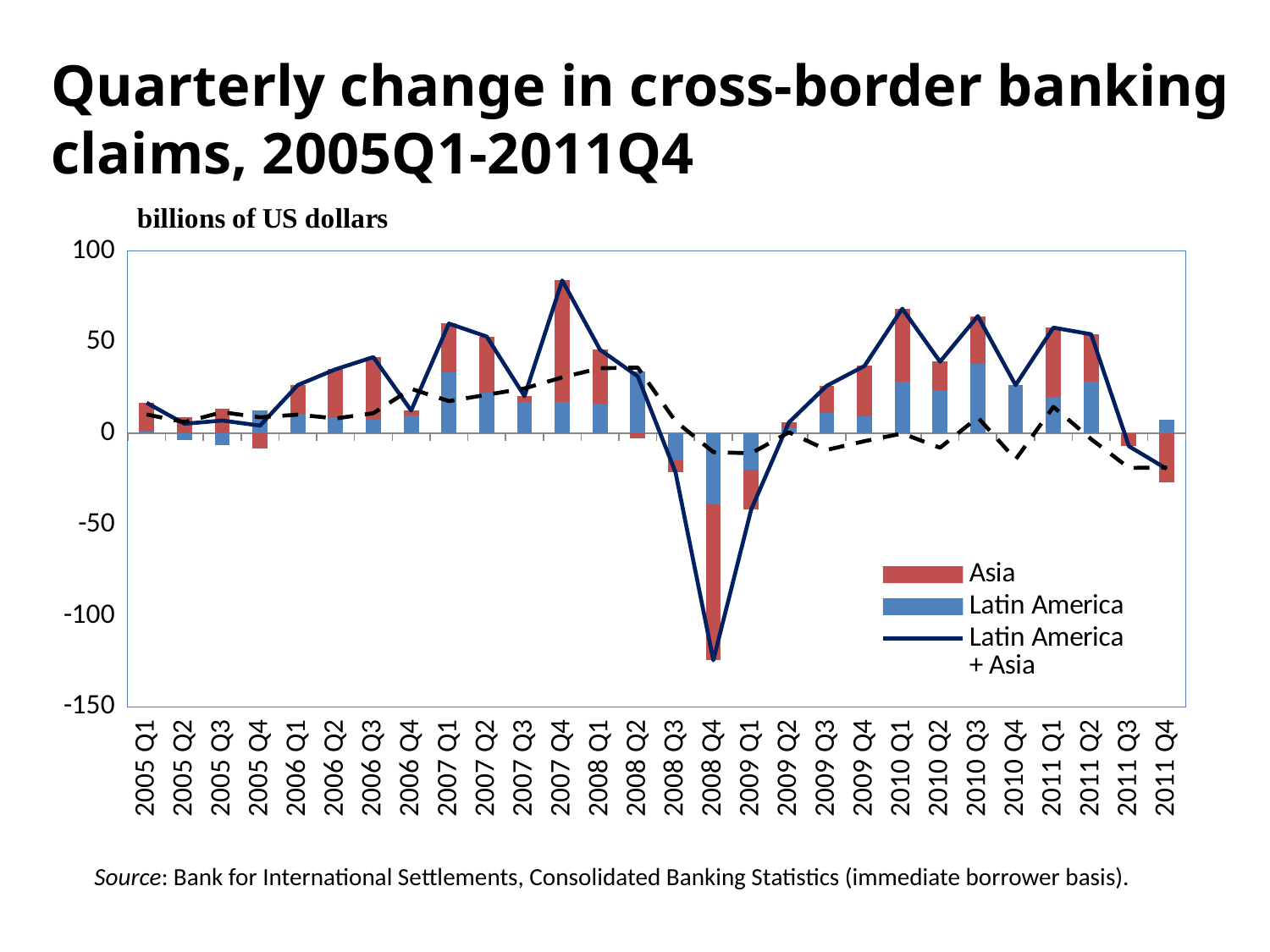
In which quarter does the Latin America + Asia line reach its lowest value? 2008 Q4 Is the Latin America + Asia value for 2010 Q1 greater or less than 50? greater Which colour represents Asia in the legend? Red How many quarters are plotted along the x axis? 28 In which quarter does the Latin America + Asia line reach its highest value? 2007 Q4 Is the Latin America + Asia value for 2009 Q1 greater or less than 0? less How many series does the legend list? 3 What kind of chart is shown on the slide? A combined bar and line chart (stacked bars with a line) What unit is stated for the values on the chart? billions of US dollars Is the Latin America + Asia value for 2008 Q4 greater or less than -100? less Which quarter has the larger Latin America + Asia value, 2007 Q4 or 2008 Q1? 2007 Q4